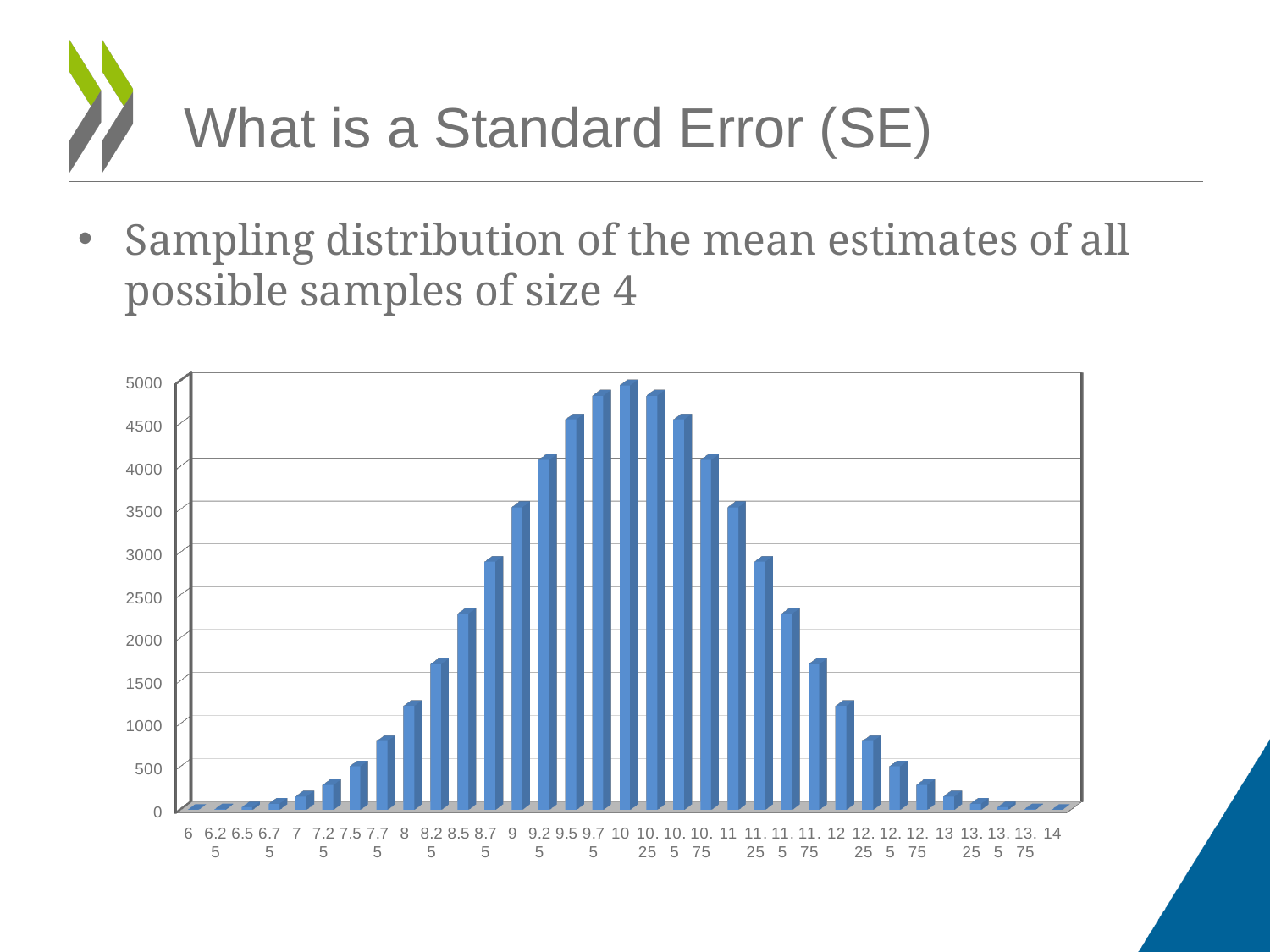
Is the value for 13 greater or less than 500? less Which category on the x axis has the highest bar? 10 Which has the larger value, 10 or 12? 10 What kind of chart is shown on the slide? bar chart Is the value for 7 greater or less than 500? less Is the value for 10 greater or less than 4500? greater How many categories are shown along the x axis? 33 Which has the larger value, 9 or 8? 9 How do the values change along the x axis from 6 to 14? They rise to a peak at 10 and then fall